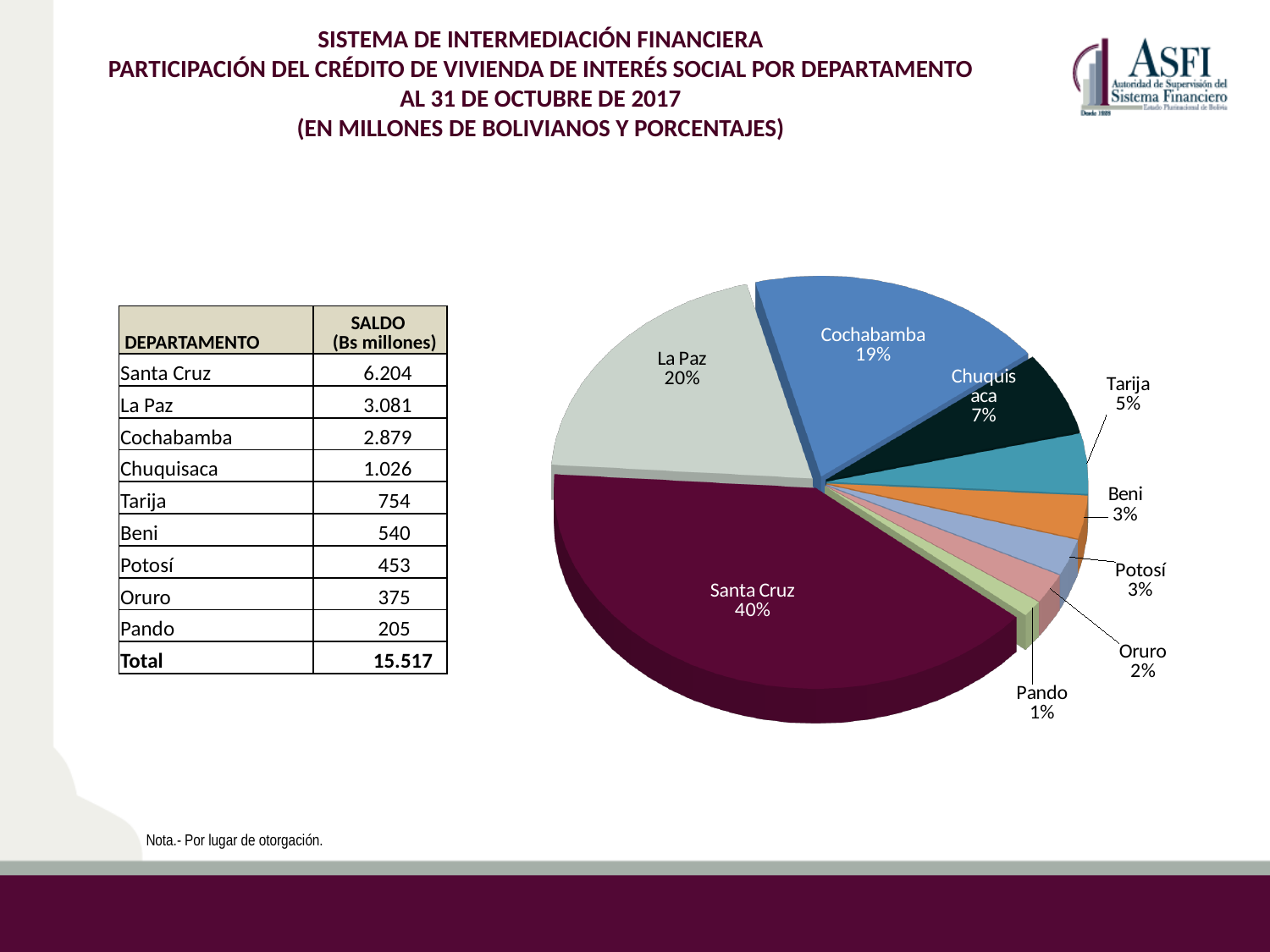
What share of the pie chart does Santa Cruz represent? 40% Which slice is larger in the pie chart, La Paz or Cochabamba? La Paz What percentage is shown for Oruro in the pie chart? 2% How many slices does the pie chart have? 9 Which department has the smallest slice of the pie chart? Pando Which department has the largest slice of the pie chart? Santa Cruz What percentage is shown for Cochabamba in the pie chart? 19% What percentage is shown for La Paz in the pie chart? 20% What is the difference in percentage points between the Santa Cruz slice and the La Paz slice? 20 percentage points What percentage is shown for Chuquisaca in the pie chart? 7% What kind of chart is shown on the slide? Pie chart What percentage is shown for Tarija in the pie chart? 5%